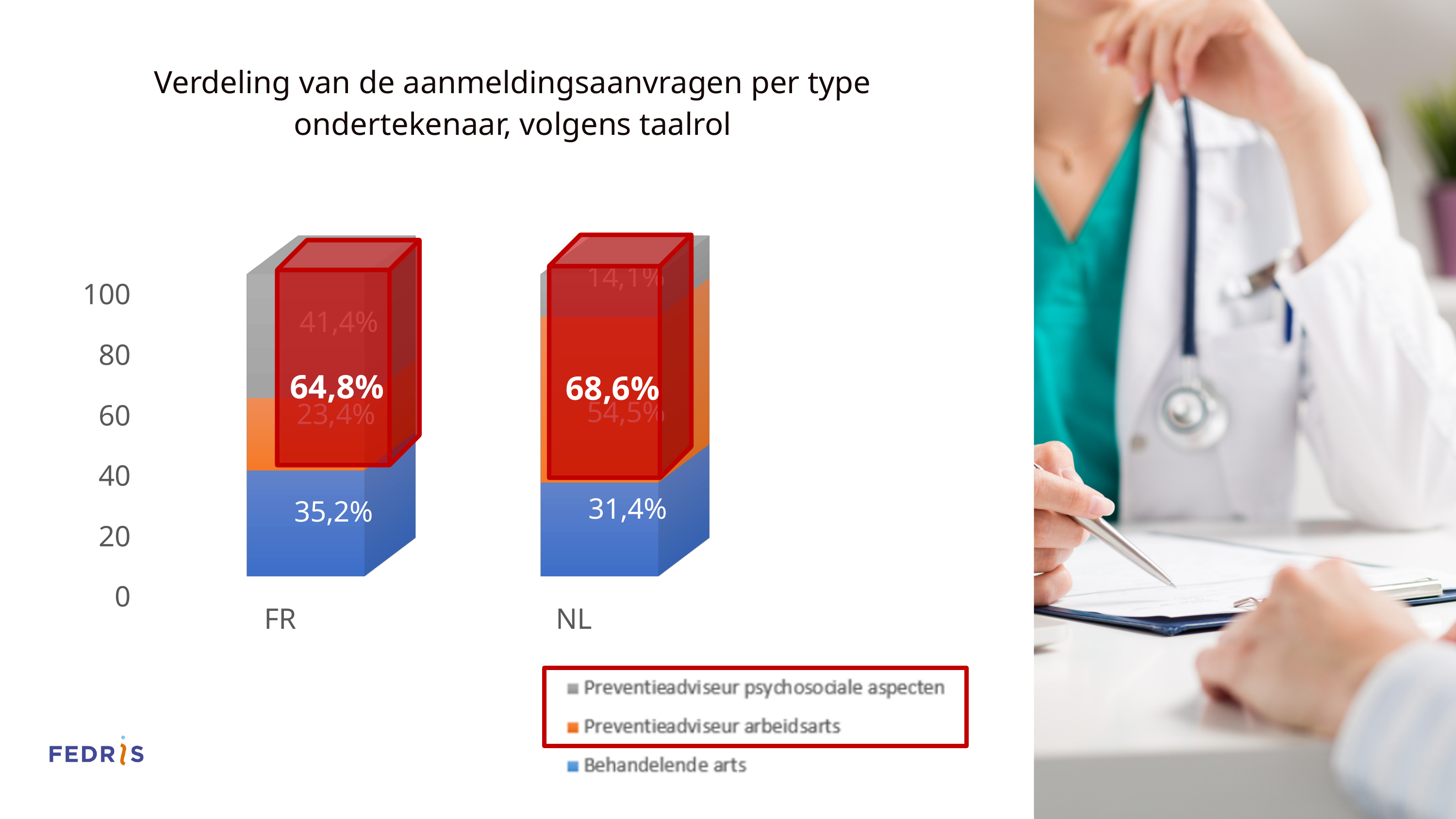
What is the value for Preventieadviseur psychosociale aspecten in the FR bar? 41,4% What combined percentage is highlighted in the red box on the NL bar? 68,6% How many categories are shown on the x axis? 2 What is the value for Behandelende arts in the FR bar? 35,2% What is the difference between the Behandelende arts values for FR and NL? 3,8% What is the value for Behandelende arts in the NL bar? 31,4% What is the value for Preventieadviseur arbeidsarts in the NL bar? 54,5% What is the value for Preventieadviseur psychosociale aspecten in the NL bar? 14,1% What combined percentage is highlighted in the red box on the FR bar? 64,8% Which category has the larger value for Behandelende arts, FR or NL? FR What kind of chart is shown on the slide? Stacked bar chart How many series does the legend list? 3